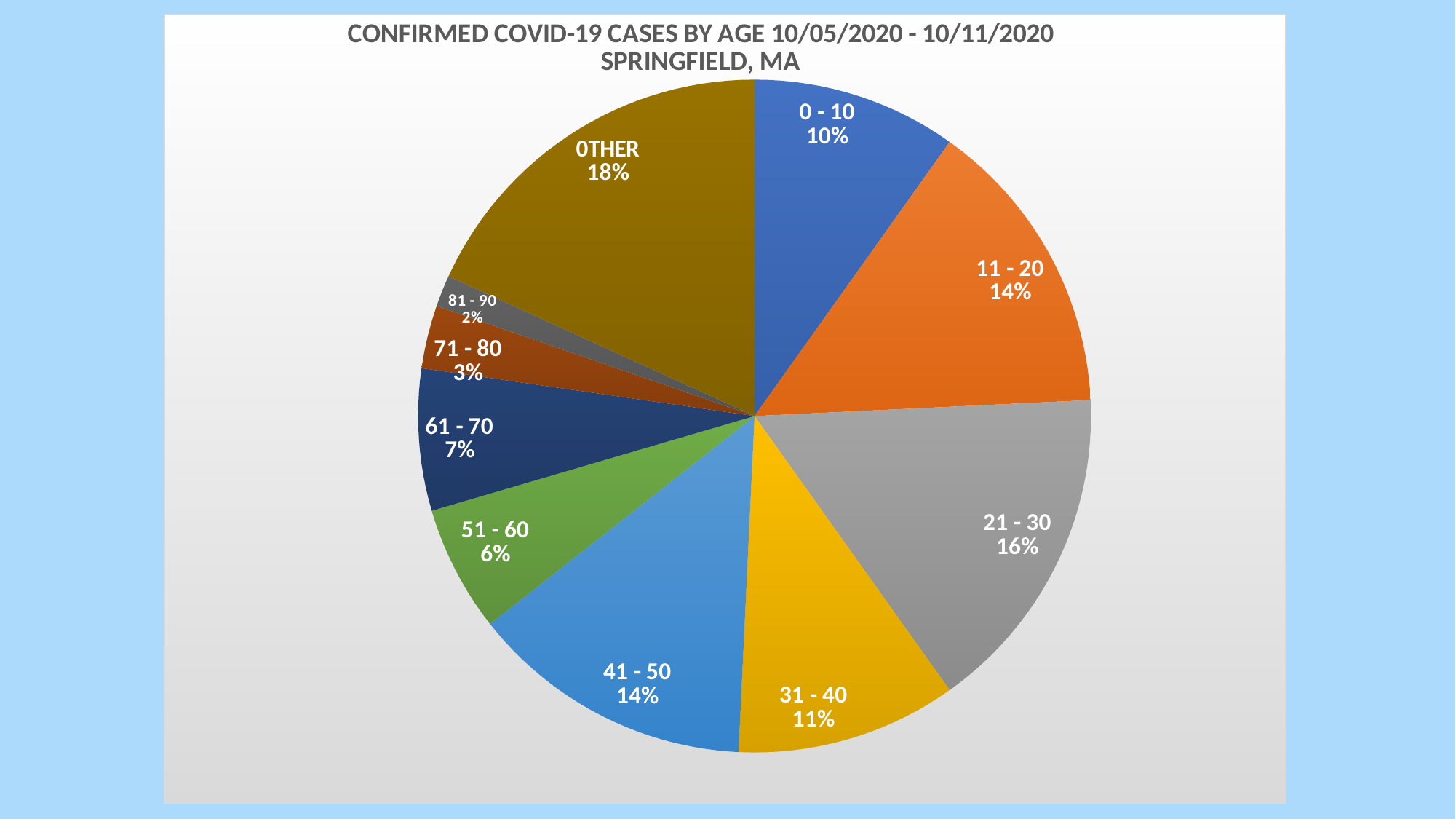
What is the difference in percentage points between the 21 - 30 and 31 - 40 age groups? 5% How many slices does the pie chart have? 10 What is the title of the chart? CONFIRMED COVID-19 CASES BY AGE 10/05/2020 - 10/11/2020 SPRINGFIELD, MA Which age group has the largest share among the labelled age ranges (excluding OTHER)? 21 - 30 What share of confirmed cases is in the 0 - 10 age group? 10% What share of confirmed cases is in the 61 - 70 age group? 7% Which slice of the pie is the smallest? 81 - 90 What share of confirmed cases is in the 21 - 30 age group? 16% Which is larger, the share for 51 - 60 or the share for 61 - 70? 61 - 70 What type of chart is shown on the slide? pie chart Which slice of the pie is the largest? OTHER